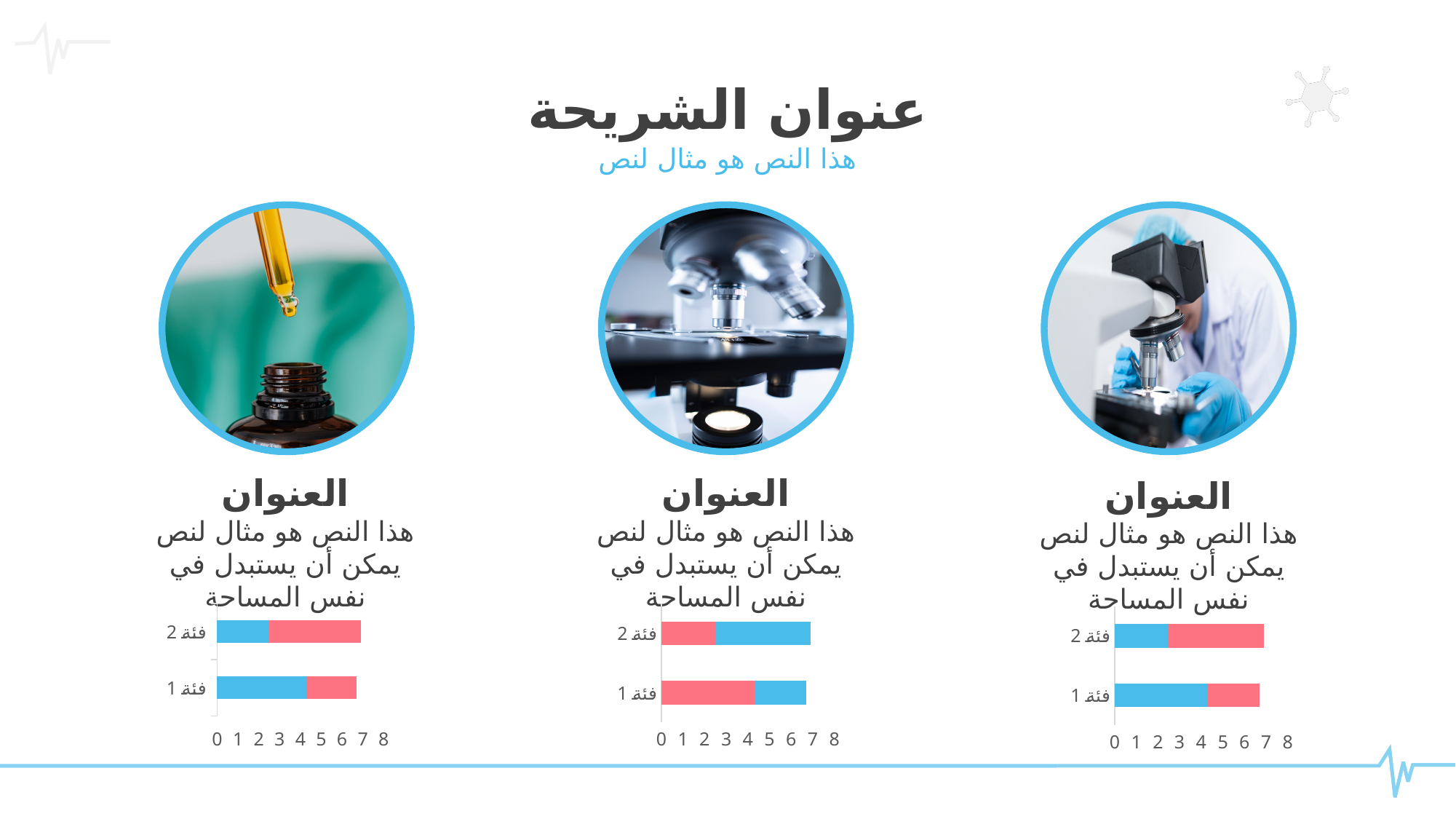
What kind of chart is shown under the left-hand column of the slide? bar chart What kind of chart is shown under the middle column of the slide? bar chart What is the highest value shown on the horizontal axis of the right-hand chart? 8 In the right-hand chart, is the blue segment of the bar for فئة 2 greater or less than 4? less In the middle chart, is the total length of the bar for فئة 1 greater or less than 5? greater In the left-hand chart, is the blue segment of the bar for فئة 1 greater or less than 3? greater In the middle chart, which colour segment appears first (nearest the axis) in each bar? pink How many categories does the chart under the right-hand column show? 2 How many categories does the chart under the left-hand column show? 2